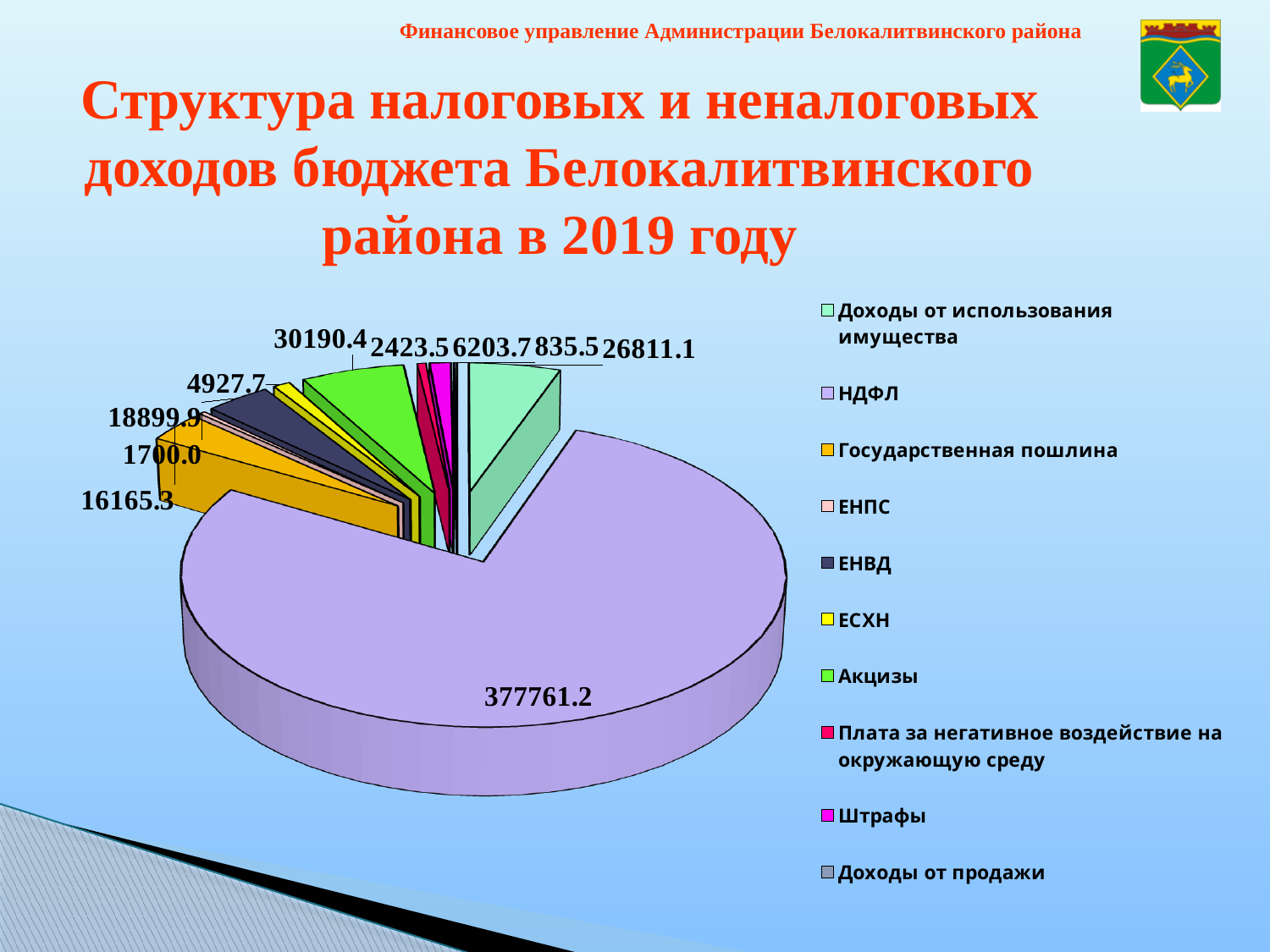
What type of chart is shown on the slide? Pie chart Which category has the smallest value? Доходы от продажи How many categories does the pie chart contain? 10 What is the value shown for Штрафы? 6203.7 What is the value shown for Акцизы? 30190.4 Which category has the largest slice of the pie? НДФЛ What is the value shown for НДФЛ? 377761.2 Which is larger, the value for ЕНВД or the value for Государственная пошлина? ЕНВД What colour is the slice for НДФЛ? Lavender (light purple) What is the value shown for Государственная пошлина? 16165.3 What is the difference between the values for Акцизы and Доходы от использования имущества? 3379.3 What is the value shown for Доходы от использования имущества? 26811.1